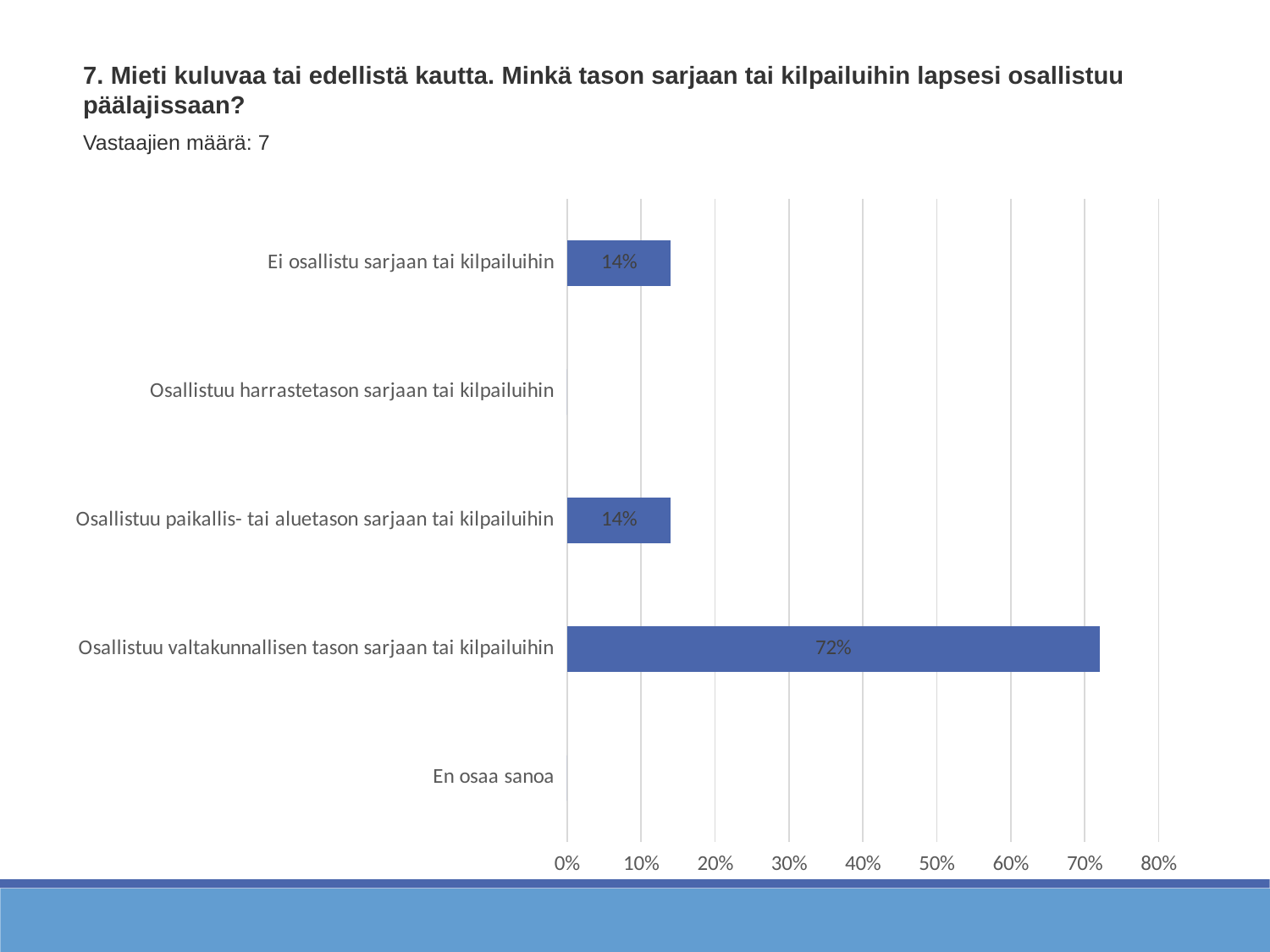
Is the value for "Osallistuu valtakunnallisen tason sarjaan tai kilpailuihin" greater or less than 50%? greater Is the value for "Ei osallistu sarjaan tai kilpailuihin" greater or less than 20%? less What is the difference between the values for "Osallistuu valtakunnallisen tason sarjaan tai kilpailuihin" and "Ei osallistu sarjaan tai kilpailuihin"? 58% What is the value for "Osallistuu paikallis- tai aluetason sarjaan tai kilpailuihin"? 14% What is the value for "Osallistuu valtakunnallisen tason sarjaan tai kilpailuihin"? 72% How many respondents does the slide report (Vastaajien määrä)? 7 Which is larger: the value for "Osallistuu valtakunnallisen tason sarjaan tai kilpailuihin" or the value for "Osallistuu paikallis- tai aluetason sarjaan tai kilpailuihin"? Osallistuu valtakunnallisen tason sarjaan tai kilpailuihin What is the highest value shown on the x axis? 80% Which category has the highest value? Osallistuu valtakunnallisen tason sarjaan tai kilpailuihin How many categories are shown on the chart? 5 What is the value for "Ei osallistu sarjaan tai kilpailuihin"? 14% What kind of chart is shown on the slide? bar chart